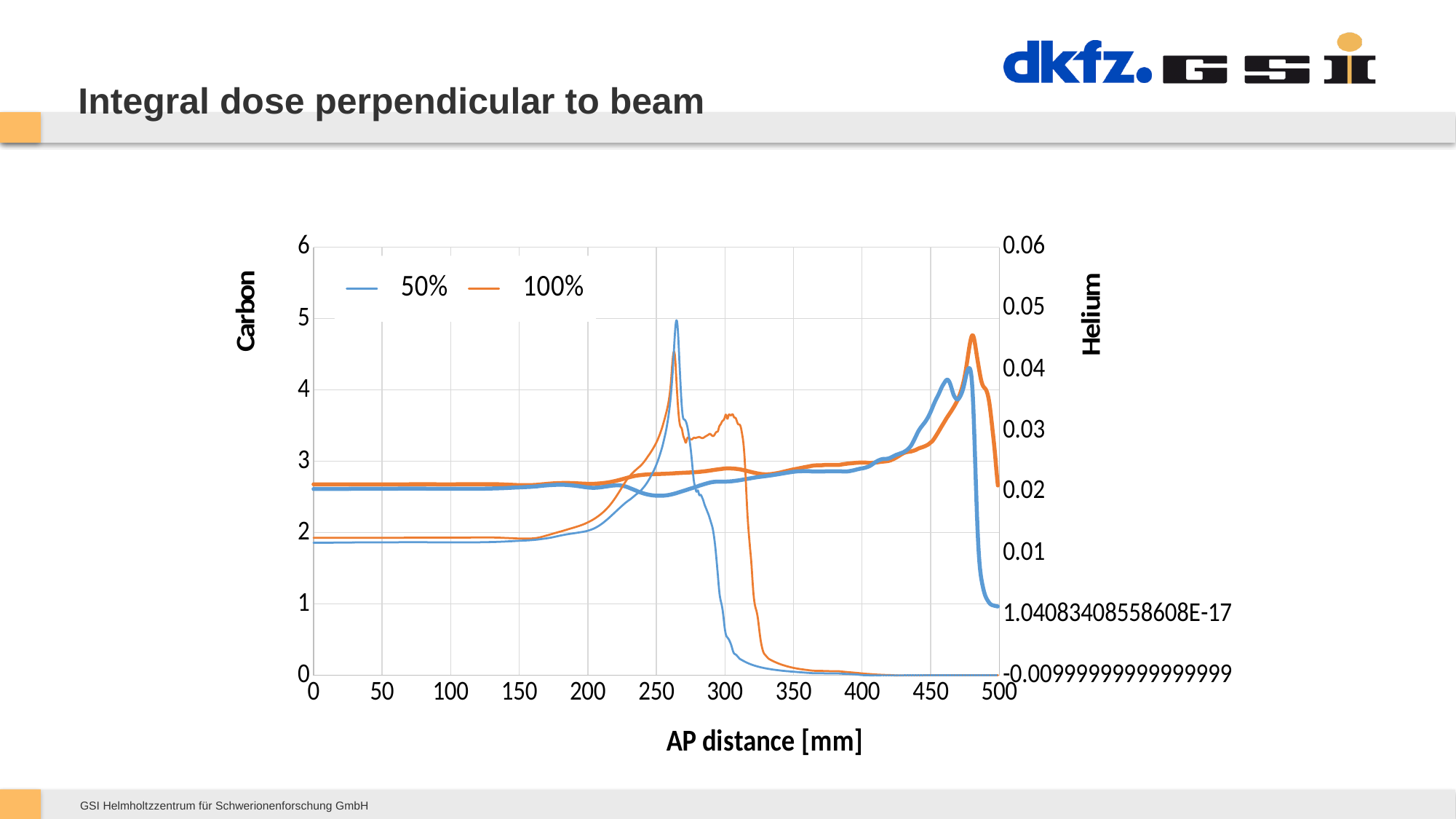
How many series does the chart legend list? 2 What are the two entries in the chart legend? 50% and 100% What kind of chart is shown on the slide? line chart What is the title of the x axis of the chart? AP distance [mm] What is the highest tick value shown on the x axis? 500 What is the highest tick value shown on the left (Carbon) axis? 6 Is the value of the thin blue 50% line at 400 mm greater or less than 1 on the Carbon axis? less Is the value of the thin blue 50% line at 0 mm greater or less than 2 on the Carbon axis? less Does the thick orange 100% line rise or fall between 400 mm and 480 mm? rise Does the thin blue 50% line rise or fall between 300 mm and 500 mm? fall Is the peak of the thin blue 50% line near 265 mm greater or less than 4 on the Carbon axis? greater